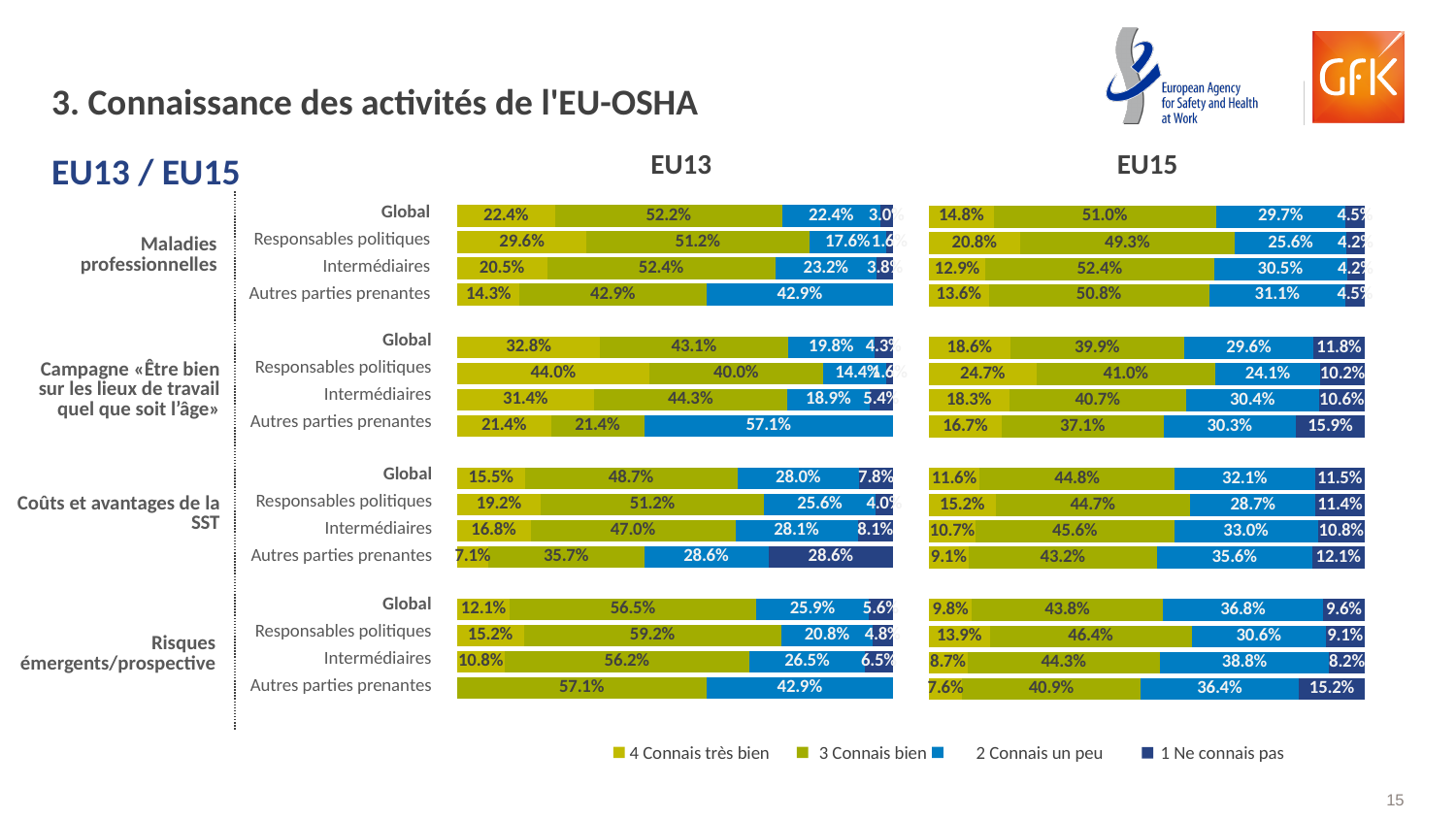
In the EU13 chart, which topic has the highest '4 Connais très bien' value in its Global row? Campagne «Être bien sur les lieux de travail quel que soit l'âge» What is the title of the chart on the right side of the slide? EU15 In the EU15 chart, what is the value of '3 Connais bien' for Autres parties prenantes under Maladies professionnelles? 50.8% In the EU15 chart, which topic has the lowest '4 Connais très bien' value in its Global row? Risques émergents/prospective What is the difference between the '2 Connais un peu' value for the Global row of Risques émergents/prospective in the EU15 chart and in the EU13 chart? 10.9 percentage points For the Global row of the Campagne «Être bien sur les lieux de travail quel que soit l'âge» topic, which chart shows the larger '4 Connais très bien' value, EU13 or EU15? EU13 In the EU15 chart, what is the value of '1 Ne connais pas' for the Global row of Campagne «Être bien sur les lieux de travail quel que soit l'âge»? 11.8% How many series does the legend list for the charts? 4 In the EU15 chart, what is the value of '2 Connais un peu' for the Global row of Coûts et avantages de la SST? 32.1% In the EU13 chart, what is the value of '3 Connais bien' for the Global row of Maladies professionnelles? 52.2% In the EU13 chart, what is the value of '4 Connais très bien' for the Global row of Risques émergents/prospective? 12.1% What kind of chart is the EU13 chart? Stacked bar chart